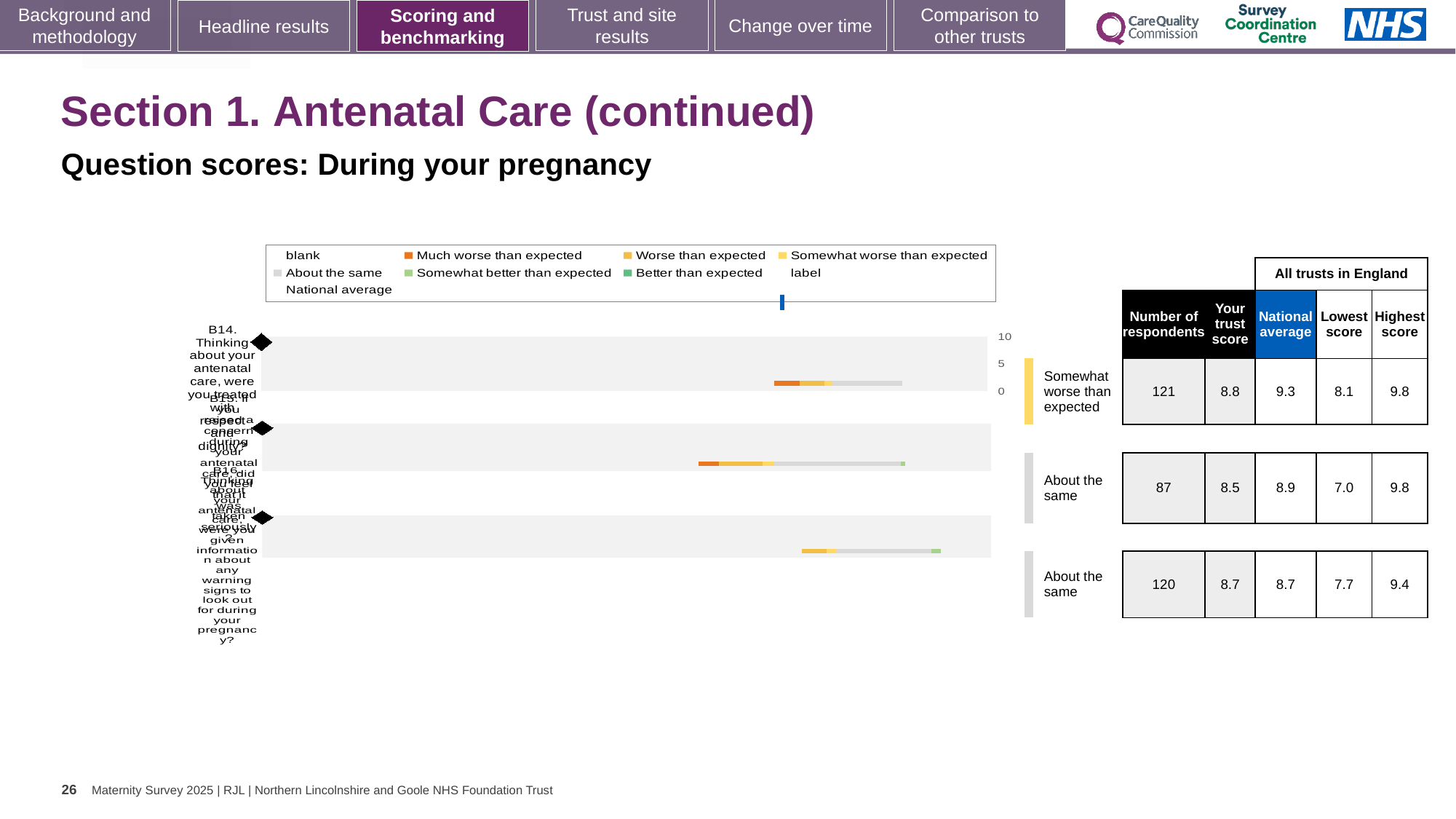
What kind of chart is shown on the slide? bar chart In the table beside the chart, what is 'Your trust score' for the first row (B14)? 8.8 How many question rows (bars) are plotted in the chart? 3 What is the highest tick value shown on the chart's numeric axis? 10 In the table beside the chart, which row has the lowest 'Your trust score'? the second row (8.5) In the chart legend, which colour represents 'Much worse than expected'? orange In the table beside the chart, what is the national average for the first row (B14)? 9.3 In the table beside the chart, is the trust score for the third row (8.7) larger or smaller than its national average (8.7)? equal In the table beside the chart, what is the number of respondents for the first row (B14, treated with respect and dignity)? 121 In the table beside the chart, what is the difference between the highest score and lowest score for the second row? 2.8